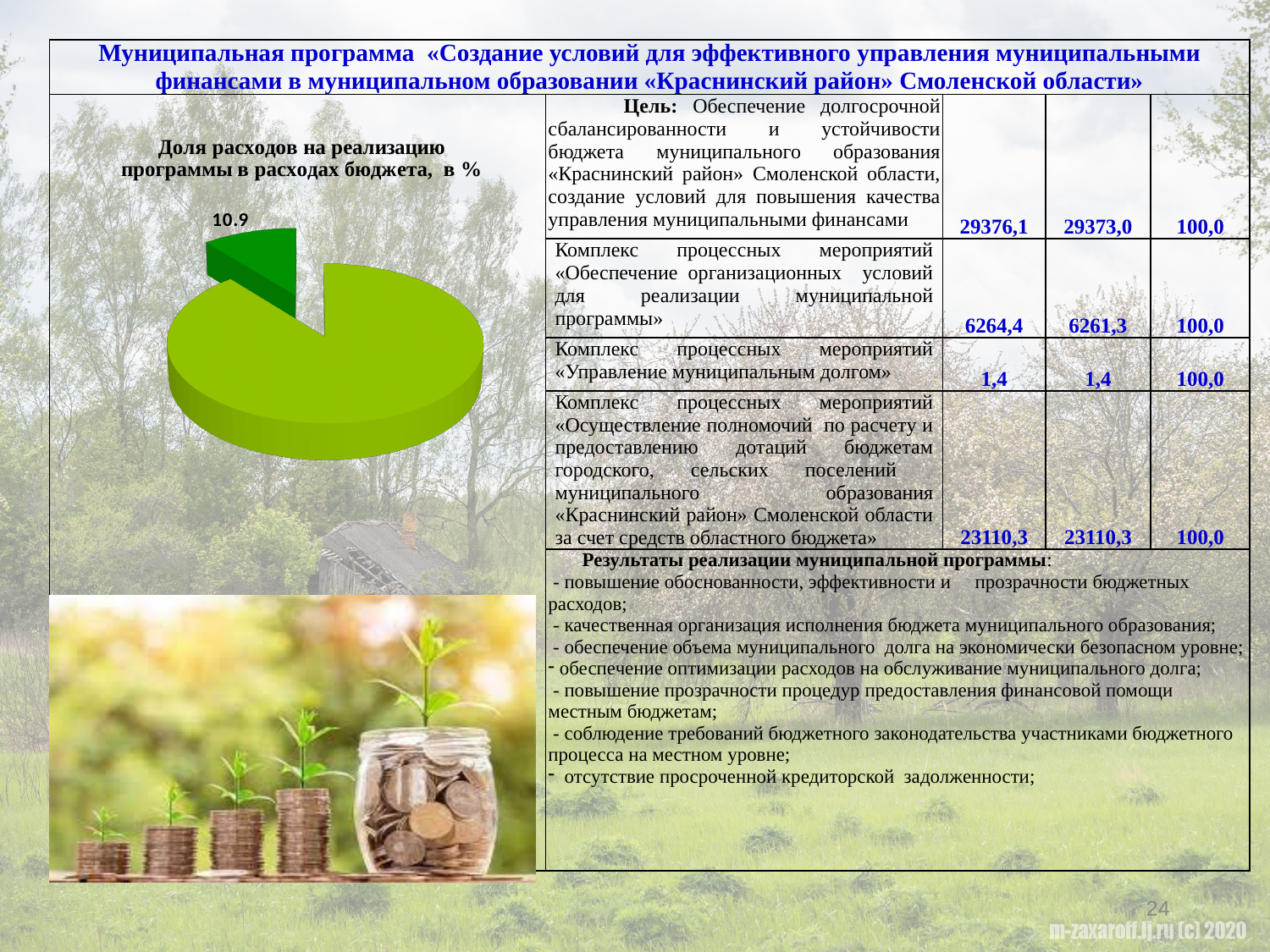
What share of budget expenditures does the dark green slice of the pie chart represent, in %? 10.9 What type of chart is shown on the left of the slide? pie chart Does the pie chart have a legend? No What value is printed on the dark green slice of the pie chart? 10.9 What is the title of the pie chart on the slide? Доля расходов на реализацию программы в расходах бюджета, в % Which slice of the pie chart is larger, the dark green one or the light green one? the light green one How many slices does the pie chart have? 2 Which slice of the pie chart is the smallest? the dark green slice (10.9)